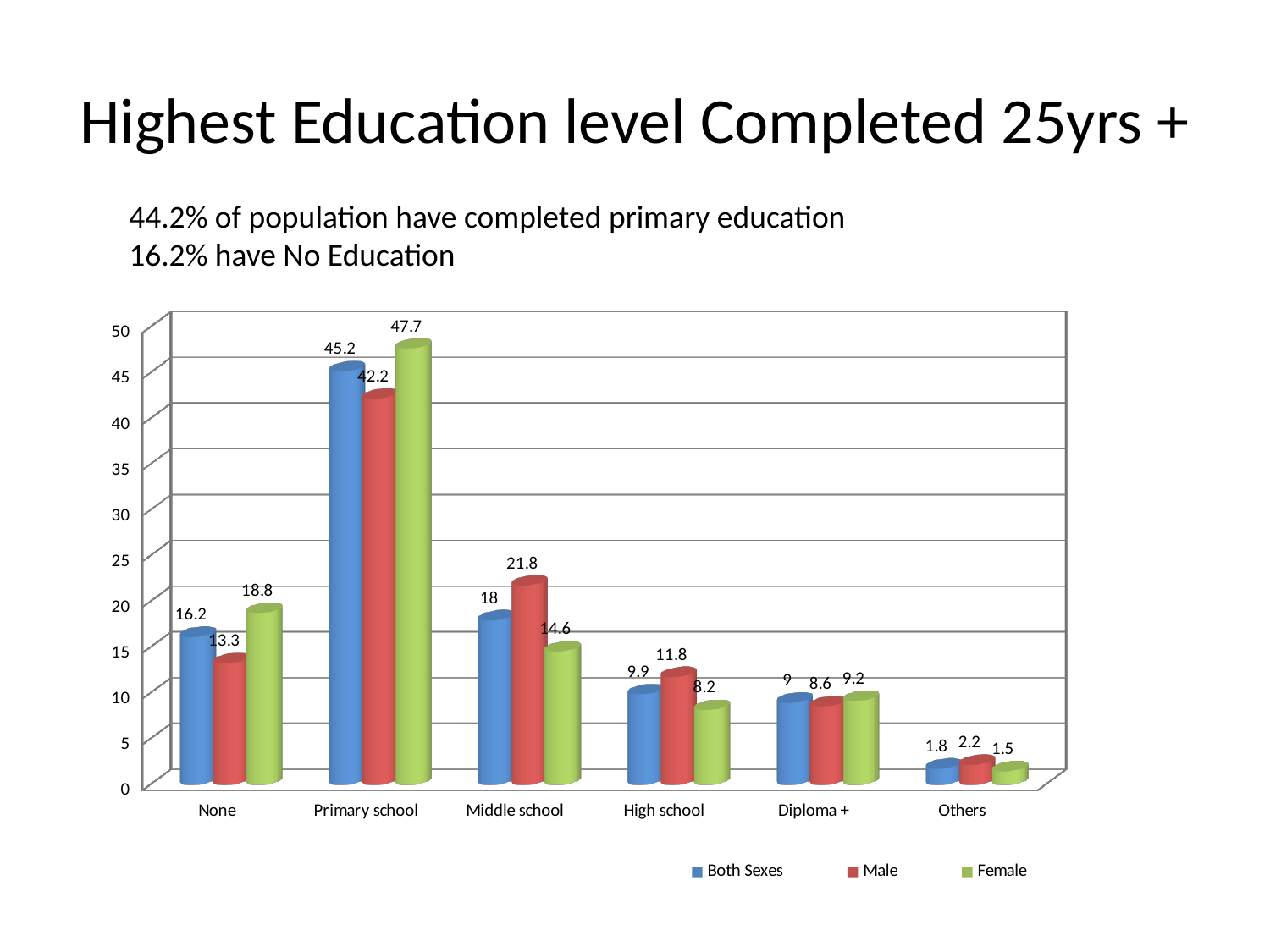
Which is larger for High school, the Male value or the Female value? Male What is the Male value for Middle school? 21.8 How many series does the legend list? 3 Which category has the highest Both Sexes value? Primary school Which category has the lowest Female value? Others What is the difference between the Male and Female values for Primary school? 5.5 Which series is shown in green in the legend? Female What is the Both Sexes value for None? 16.2 Is the Both Sexes value for Middle school greater or less than 15? greater What is the Female value for Primary school? 47.7 What kind of chart is shown on the slide? bar chart How many education categories are shown on the x axis? 6